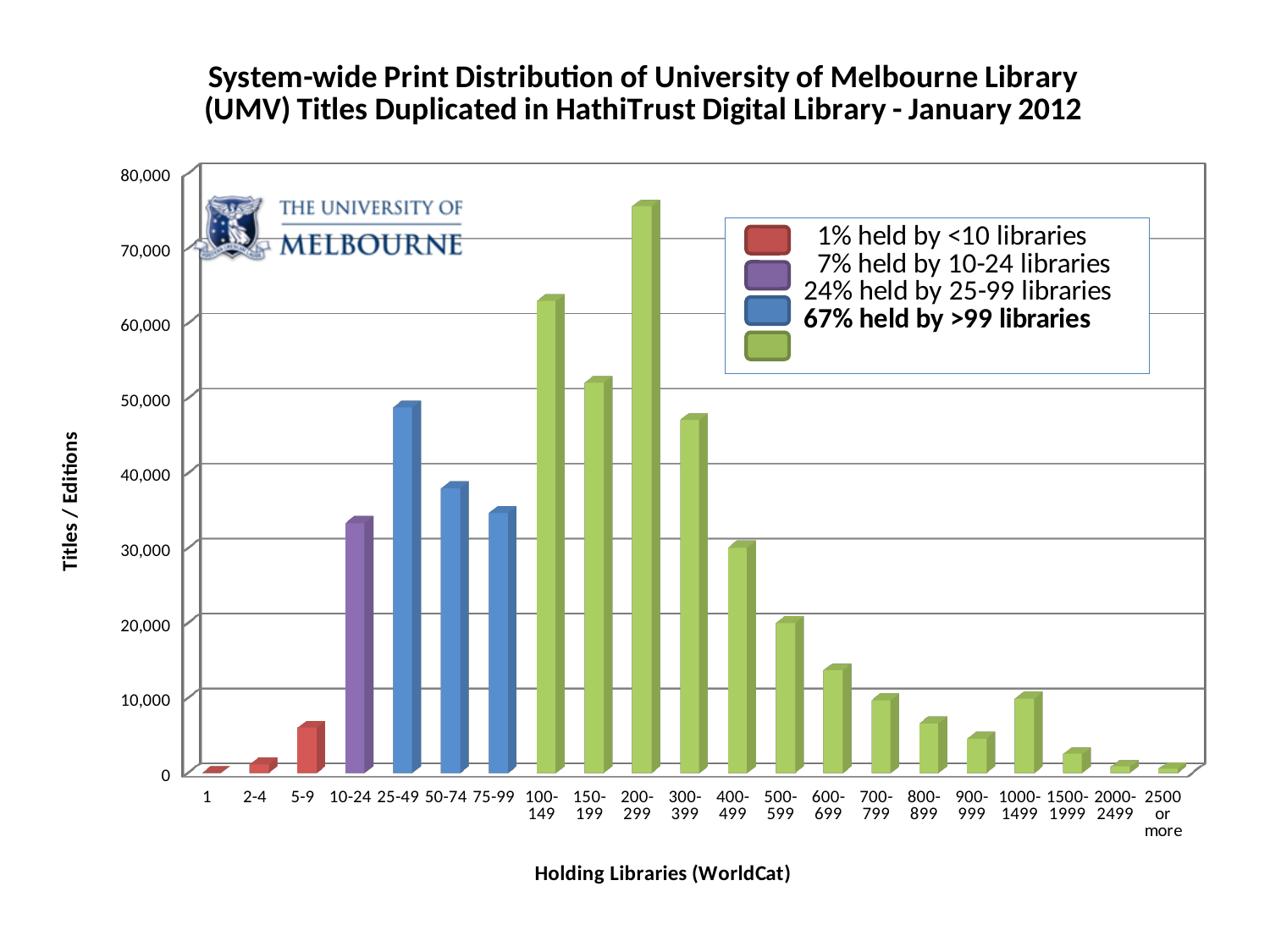
Is the value for the 10-24 category greater or less than 30,000? greater Which has more titles / editions, the 50-74 category or the 75-99 category? 50-74 Which has more titles / editions, the 100-149 category or the 150-199 category? 100-149 Is the value for the 5-9 category greater or less than 10,000? less Which holding-libraries category has the highest number of titles / editions? 200-299 How many colour entries does the chart's legend list? 4 From the 200-299 category onward to the right, do the values generally rise or fall? fall According to the legend, what percentage of titles is held by more than 99 libraries? 67% What kind of chart is shown on the slide? bar chart Is the value for the 100-149 category greater or less than 60,000? greater How many categories are shown along the x axis of the chart? 21